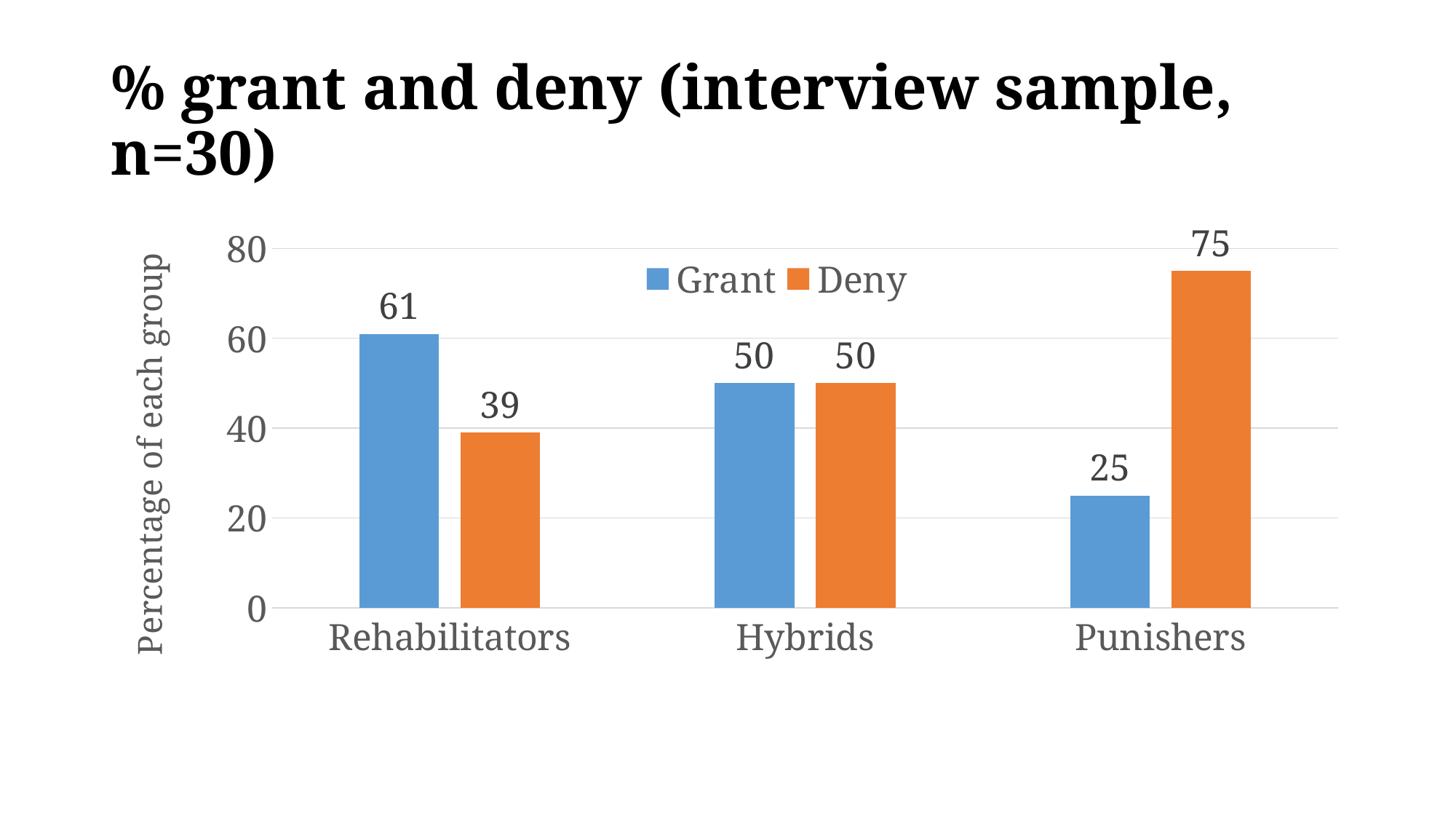
How many categories are shown on the x axis? 3 What kind of chart is shown on the slide? Bar chart How many series does the legend list? 2 Which category has the lowest Grant value? Punishers What is the Deny value for Punishers? 75 What is the Grant value for Hybrids? 50 What is the label of the vertical axis? Percentage of each group Which category has the highest Deny value? Punishers What is the difference between the Deny value for Punishers and the Deny value for Rehabilitators? 36 What is the Grant value for Rehabilitators? 61 Which is larger for Punishers, the Grant value or the Deny value? Deny What is the difference between the Grant and Deny values for Rehabilitators? 22